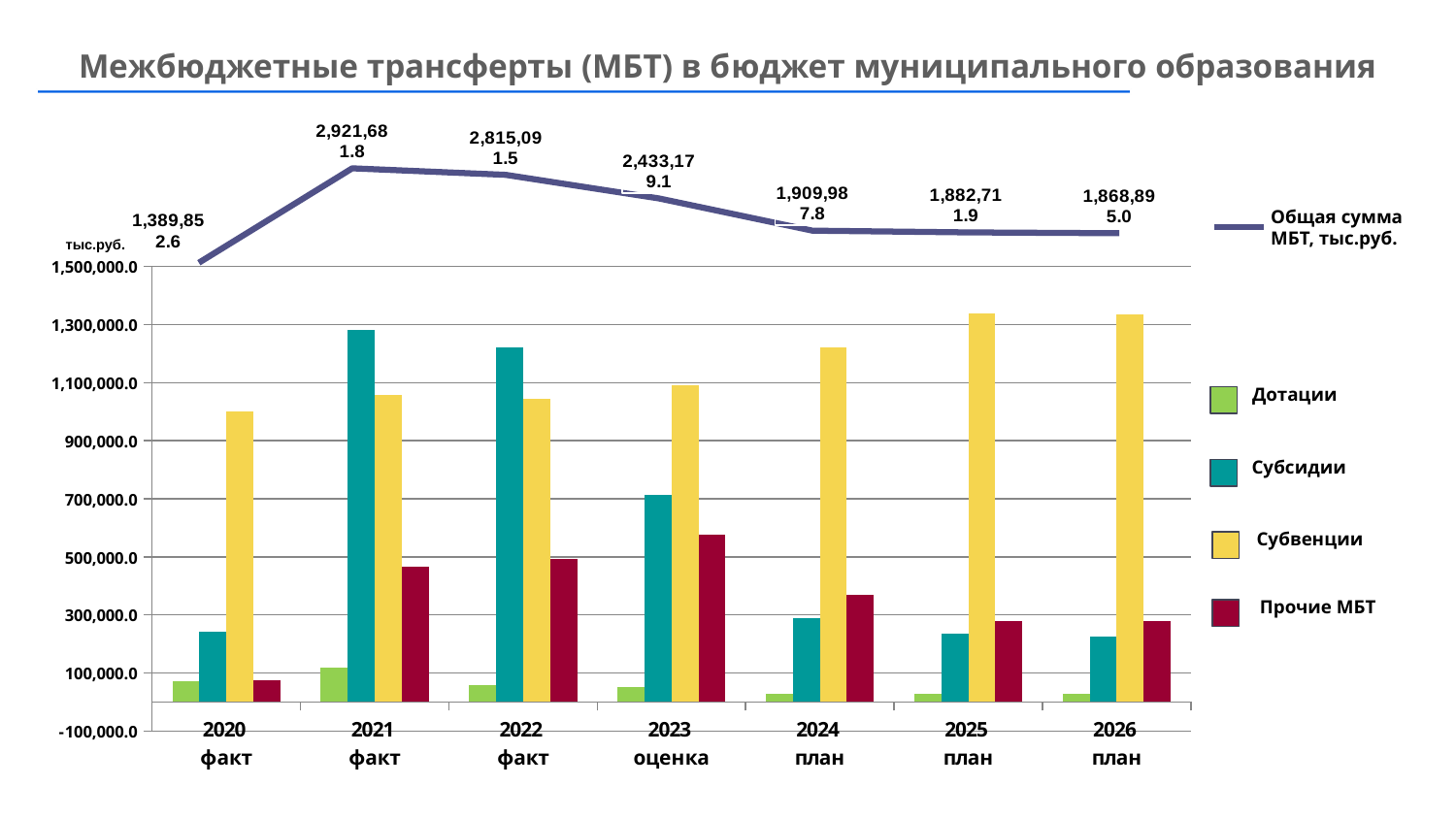
In which year is the 'Субсидии' bar the tallest? 2021 факт What is the difference between 'Общая сумма МБТ' for 2021 факт and 2022 факт? 106,590.3 In which year is the line 'Общая сумма МБТ, тыс.руб.' at its lowest? 2020 факт How many series does the legend list? 5 Does the line 'Общая сумма МБТ, тыс.руб.' rise or fall from 2021 to 2026? fall How many year categories are shown on the x axis? 7 In which year is the line 'Общая сумма МБТ, тыс.руб.' at its highest? 2021 факт Is the value of 'Субсидии' for 2021 факт greater or less than 1,100,000.0? greater In 2020 факт, which is larger: 'Субвенции' or 'Субсидии'? Субвенции What is the value of 'Общая сумма МБТ, тыс.руб.' for 2021 факт? 2,921,681.8 What is the value of 'Общая сумма МБТ, тыс.руб.' for 2026 план? 1,868,895.0 What kind of chart is shown on the slide? bar chart with a line